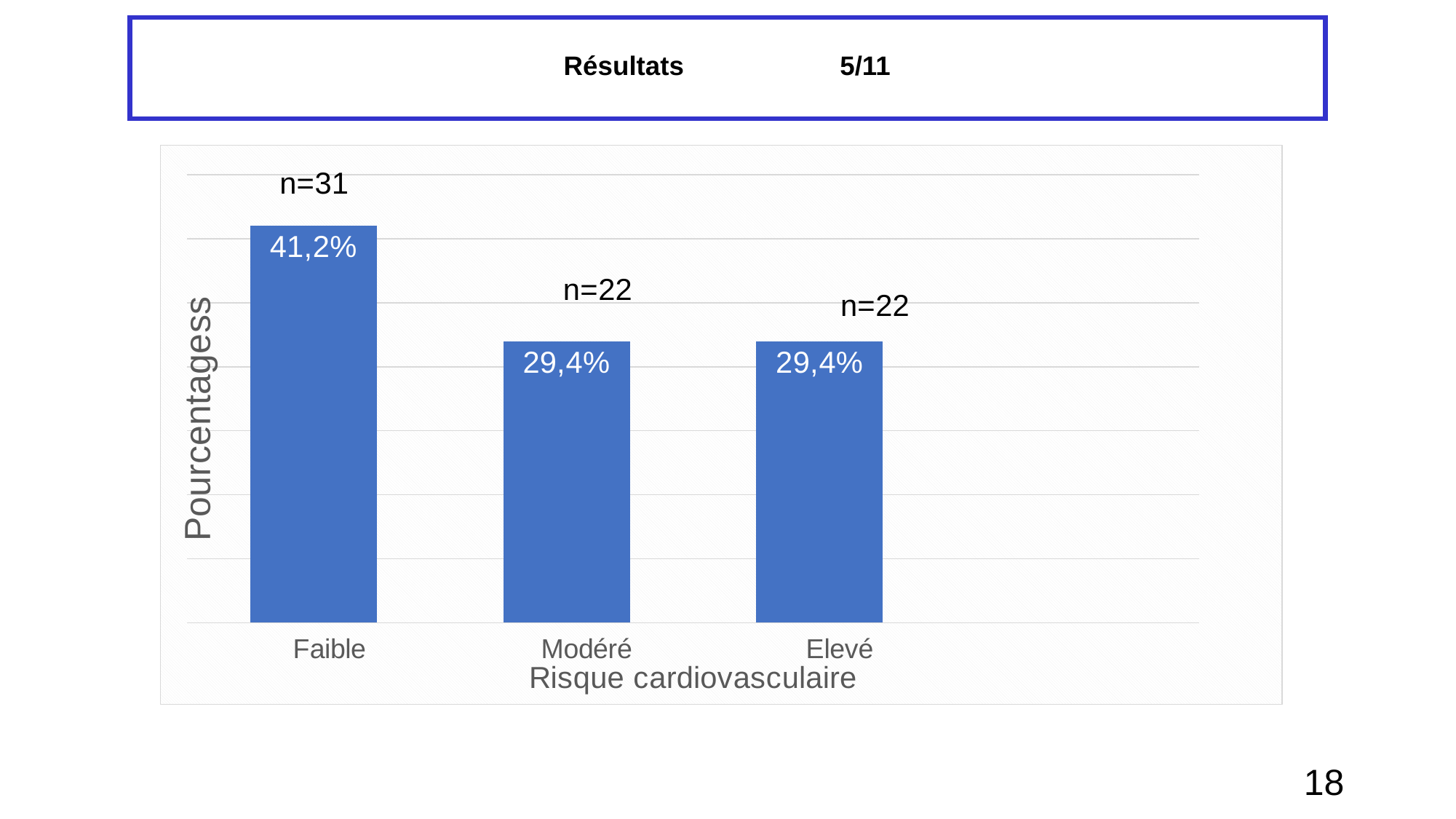
What is the percentage value for the Elevé category? 29,4% What is the label of the y axis? Pourcentagess What is the percentage value for the Modéré category? 29,4% How many categories are shown on the x axis? 3 What is the difference in percentage between Faible and Modéré? 11,8% What is the n value shown above the Elevé bar? n=22 What kind of chart is shown on the slide? Bar chart Which cardiovascular risk category has the highest percentage? Faible What is the n value shown above the Faible bar? n=31 What is the percentage value for the Faible category? 41,2% Which is larger, the percentage for Faible or the percentage for Elevé? Faible What is the label of the x axis? Risque cardiovasculaire